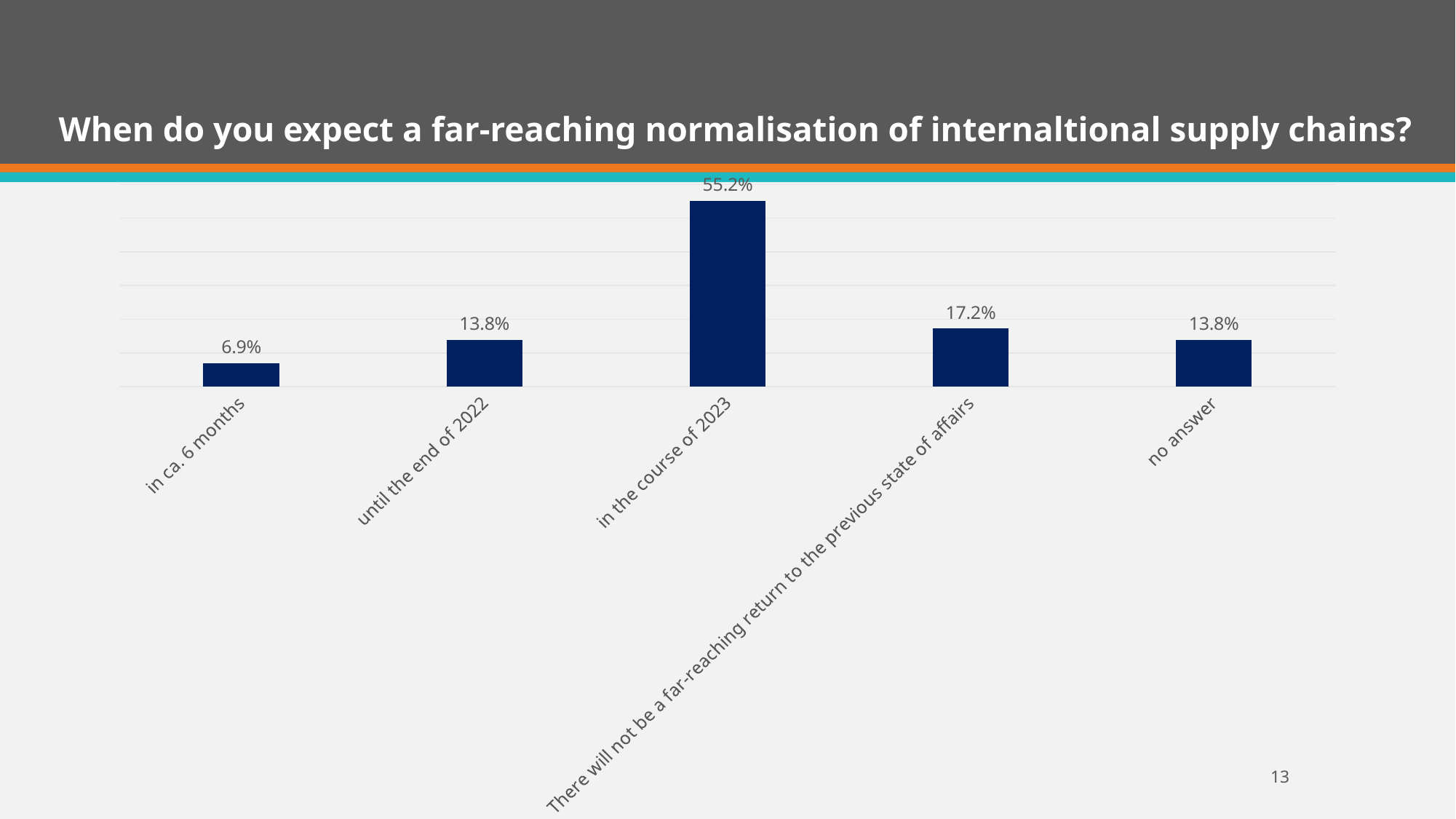
What is the value for 'no answer'? 13.8% What is the difference between the values for 'in the course of 2023' and 'until the end of 2022'? 41.4% Which is larger: the value for 'There will not be a far-reaching return to the previous state of affairs' or the value for 'no answer'? There will not be a far-reaching return to the previous state of affairs What is the title of the slide? When do you expect a far-reaching normalisation of internaltional supply chains? How many categories are shown in the chart? 5 What is the difference between the values for 'There will not be a far-reaching return to the previous state of affairs' and 'in ca. 6 months'? 10.3% What kind of chart is shown on the slide? Bar chart What percentage of respondents said there will not be a far-reaching return to the previous state of affairs? 17.2% What percentage of respondents expect a far-reaching normalisation of international supply chains in ca. 6 months? 6.9% Which category has the lowest value? in ca. 6 months Which category has the highest value? in the course of 2023 What is the value for 'in the course of 2023'? 55.2%